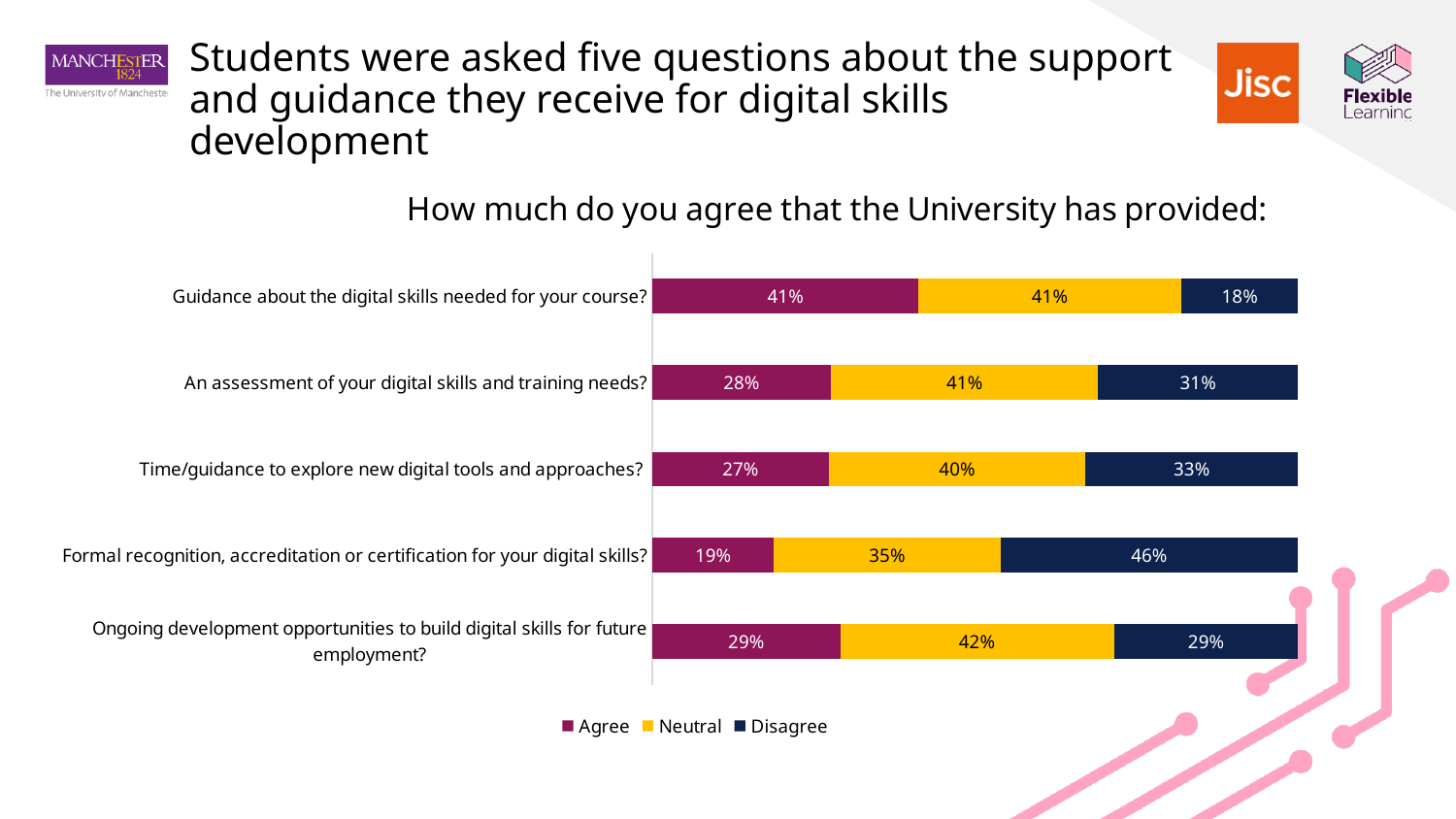
Which question has the lowest Agree percentage? Formal recognition, accreditation or certification for your digital skills? What kind of chart is shown on the slide? Stacked bar chart How many questions (categories) are shown in the chart? 5 What percentage of students disagree that the University has provided formal recognition, accreditation or certification for their digital skills? 46% Which series is shown in yellow in the chart? Neutral How many series does the legend list? 3 Which is larger: the Agree percentage for 'An assessment of your digital skills and training needs?' or the Agree percentage for 'Time/guidance to explore new digital tools and approaches?' An assessment of your digital skills and training needs? What is the Neutral percentage for 'Ongoing development opportunities to build digital skills for future employment?' 42% Which question has the highest Agree percentage? Guidance about the digital skills needed for your course? What percentage of students agree that the University has provided guidance about the digital skills needed for their course? 41% What is the difference between the Disagree percentage for 'Formal recognition, accreditation or certification for your digital skills?' and the Disagree percentage for 'Guidance about the digital skills needed for your course?' 28% What is the total of the three segments for 'Time/guidance to explore new digital tools and approaches?' 100%